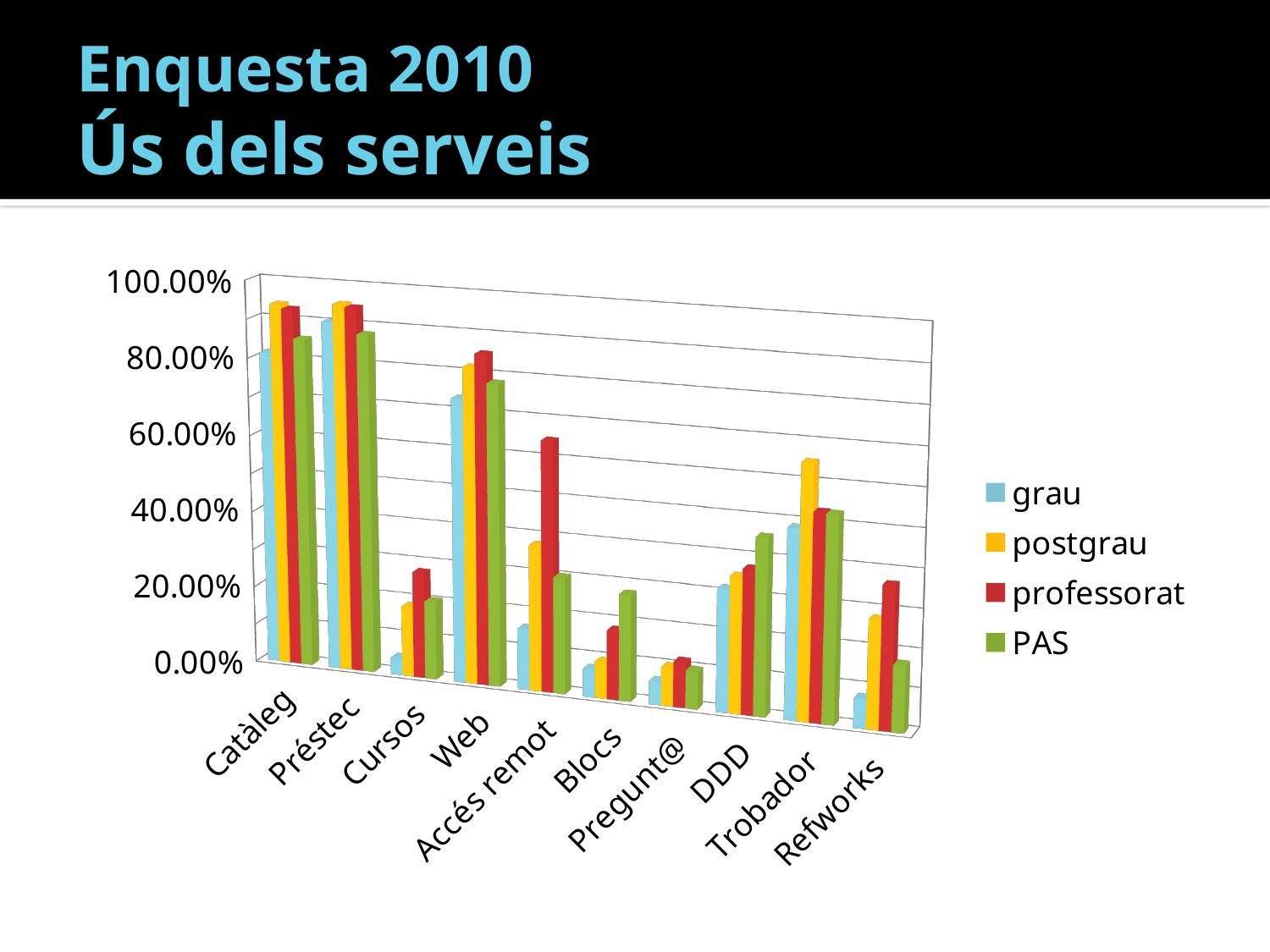
What kind of chart is shown on the slide? bar chart For Cursos, which is larger: the professorat value or the grau value? professorat How many series does the chart's legend list? 4 Is the grau value for Refworks greater or less than 20.00%? less For Trobador, which is larger: the postgrau value or the grau value? postgrau Is the postgrau value for Catàleg greater or less than 80.00%? greater Which series are listed in the chart's legend? grau, postgrau, professorat, PAS How many categories are shown along the x axis of the chart? 10 Which category has the highest grau value? Préstec Is the professorat value for Accés remot greater or less than 40.00%? greater For Accés remot, which series has the highest value? professorat